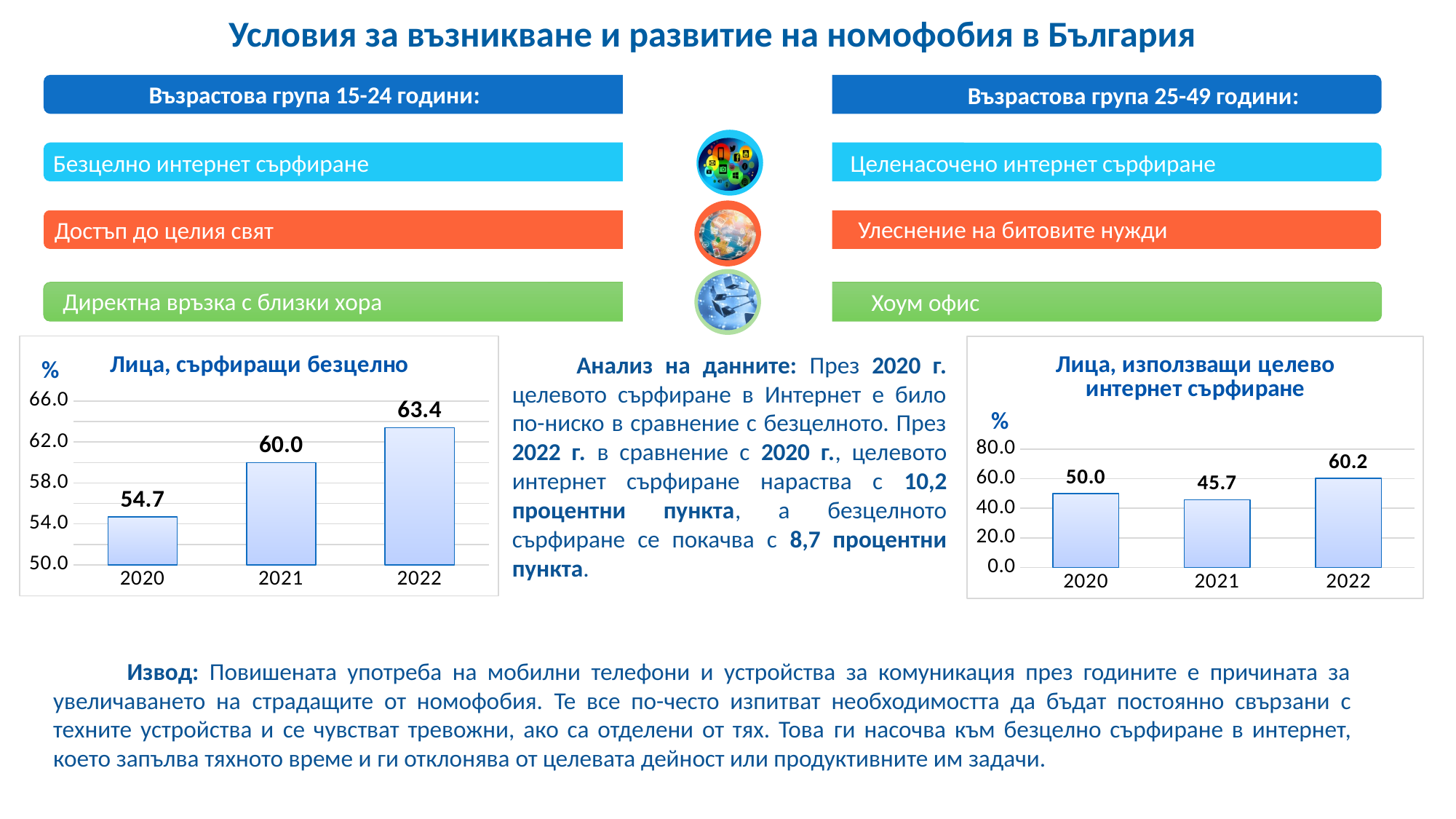
In the chart titled "Лица, използващи целево интернет сърфиране", what is the difference between the values for 2022 and 2020? 10.2 In the chart titled "Лица, сърфиращи безцелно", what is the difference between the values for 2022 and 2020? 8.7 What kind of chart is the chart titled "Лица, използващи целево интернет сърфиране"? bar chart In the chart titled "Лица, използващи целево интернет сърфиране", what is the value for 2022? 60.2 How many years are shown in the chart titled "Лица, сърфиращи безцелно"? 3 In the chart titled "Лица, използващи целево интернет сърфиране", which year has the lowest value? 2021 In the chart titled "Лица, сърфиращи безцелно", do the values rise or fall from 2020 to 2022? rise In the chart titled "Лица, сърфиращи безцелно", which year has the highest value? 2022 In the chart titled "Лица, сърфиращи безцелно", what is the value for 2020? 54.7 In the chart titled "Лица, използващи целево интернет сърфиране", what is the value for 2021? 45.7 In the chart titled "Лица, сърфиращи безцелно", what is the value for 2022? 63.4 In the chart titled "Лица, използващи целево интернет сърфиране", which is larger, the value for 2020 or the value for 2021? 2020